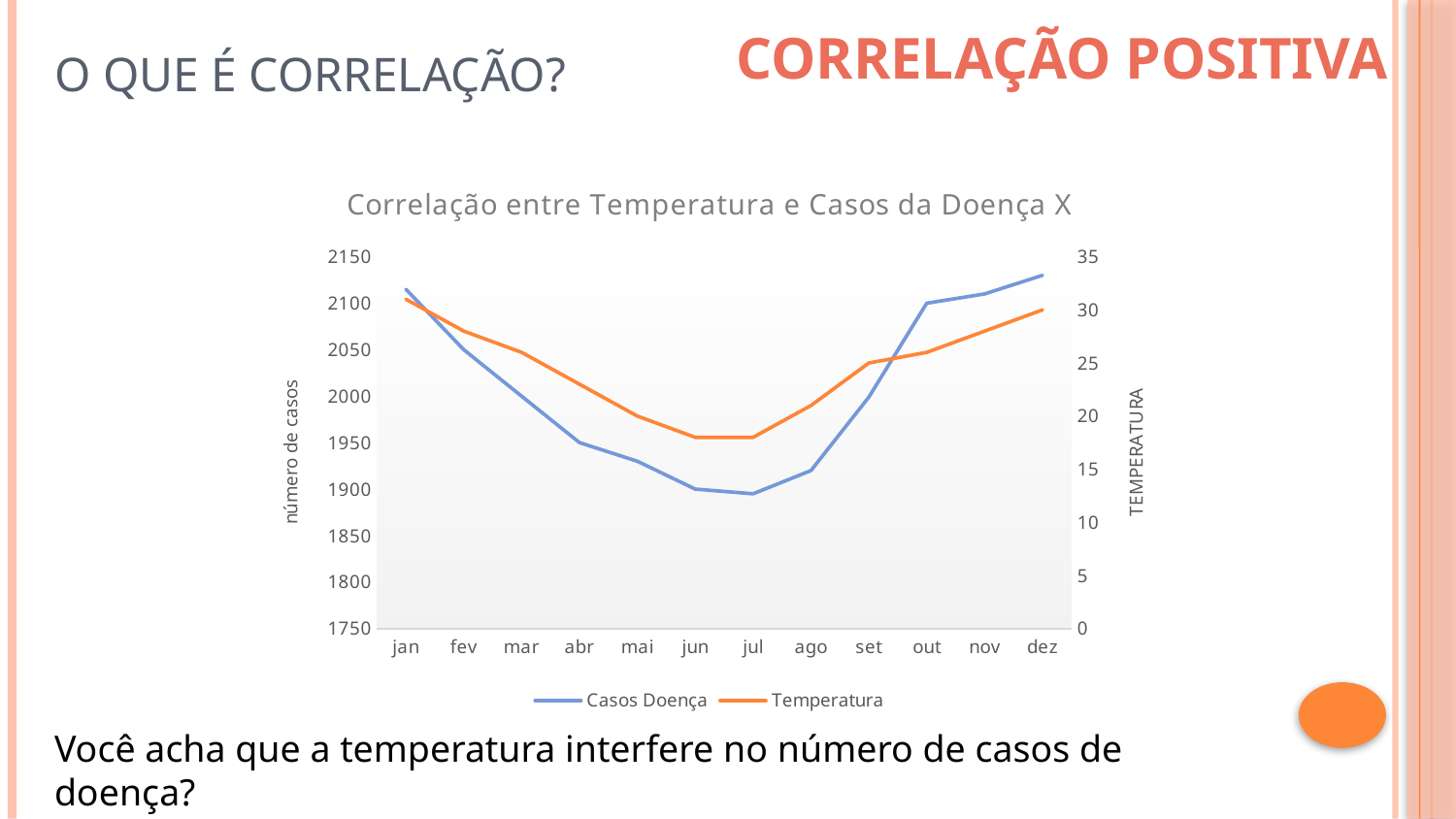
Does the Temperatura series rise or fall from jul to dez? rise Is the Casos Doença value for abr greater or less than 2000? less Does the Casos Doença series rise or fall from jan to jul? fall What is the label of the right-hand vertical axis? TEMPERATURA Is the Temperatura value for set greater or less than 20? greater How many series does the legend list? 2 Is the Temperatura value for jun greater or less than 20? less In which month is the Casos Doença series at its highest? dez Which is larger for Casos Doença: the value for fev or the value for ago? fev How many months are plotted along the x axis? 12 What kind of chart is shown on the slide? line chart What is the title of the chart? Correlação entre Temperatura e Casos da Doença X